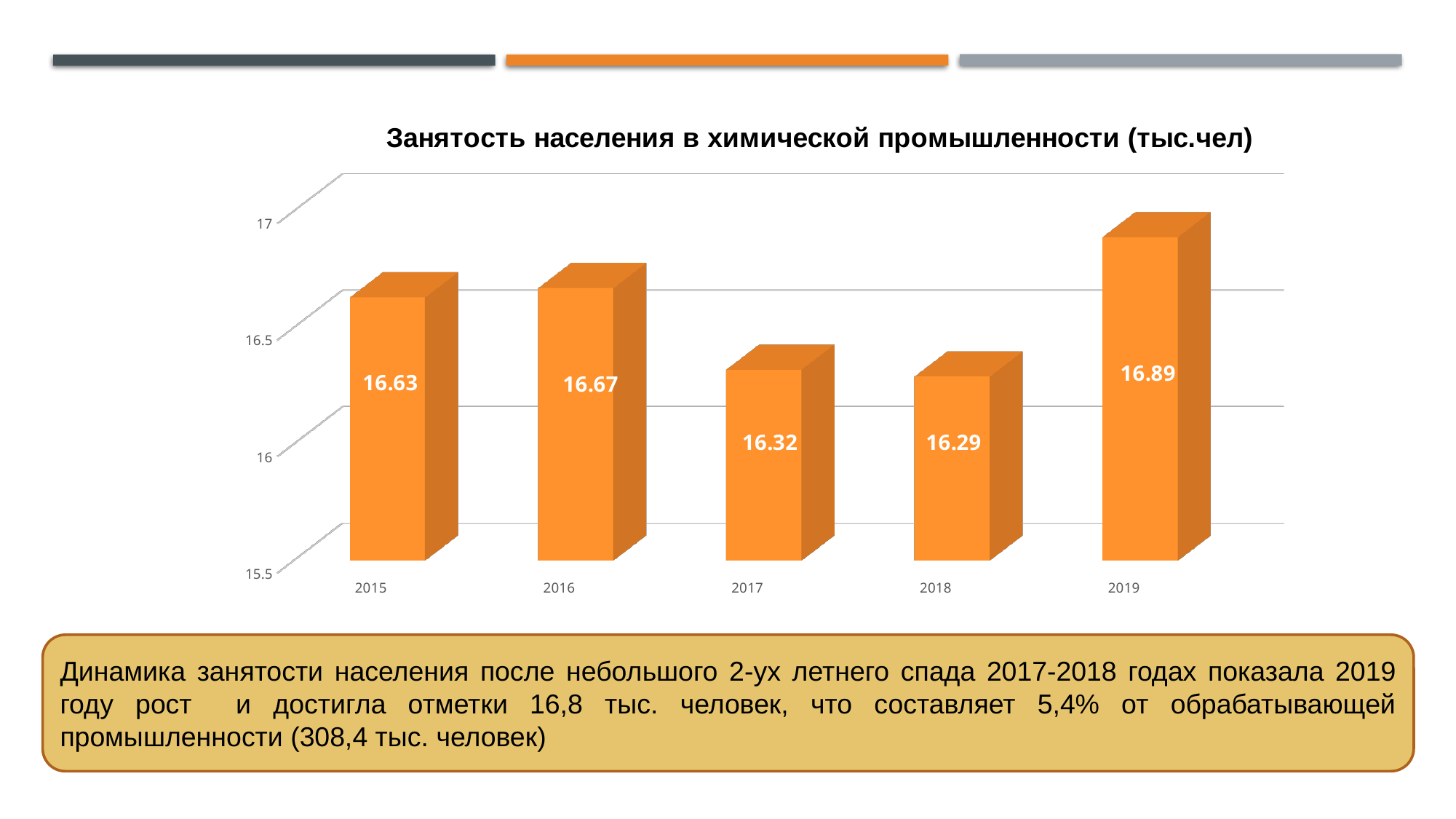
What is the employment value for 2015? 16.63 Which is larger, the value for 2016 or the value for 2017? 2016 What is the difference between the 2019 and 2018 values? 0.6 What is the employment value for 2019? 16.89 Which year has the lowest employment in the chemical industry? 2018 How many years are shown on the x axis? 5 Is the value for 2019 greater or less than 16.5? greater What is the difference between the 2016 and 2015 values? 0.04 Which year has the highest employment in the chemical industry? 2019 What kind of chart is shown on the slide? bar chart What is the title of the chart? Занятость населения в химической промышленности (тыс.чел) What is the employment value for 2017? 16.32